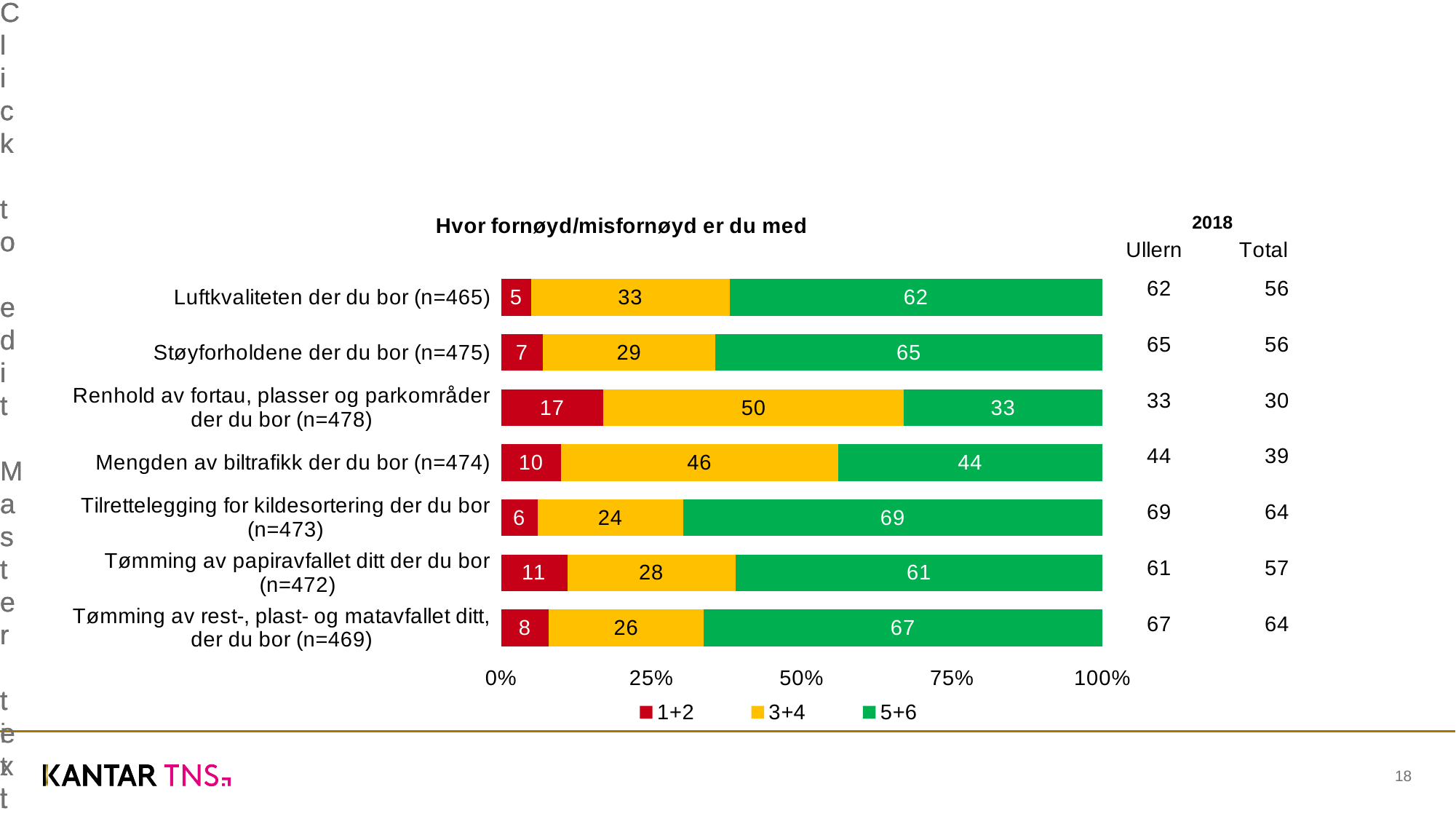
How many series does the legend list? 3 How many categories are shown in the chart? 7 What is the value of the 3+4 segment for Mengden av biltrafikk der du bor (n=474)? 46 What is the title of the chart? Hvor fornøyd/misfornøyd er du med Which category has the highest 5+6 value? Tilrettelegging for kildesortering der du bor (n=473) What kind of chart is shown on the slide? Stacked bar chart What is the value of the 5+6 segment for Luftkvaliteten der du bor (n=465)? 62 Which category has the lowest 5+6 value? Renhold av fortau, plasser og parkområder der du bor (n=478) What is the difference between the 5+6 values for Støyforholdene der du bor (n=475) and Luftkvaliteten der du bor (n=465)? 3 What is the value of the 1+2 segment for Renhold av fortau, plasser og parkområder der du bor (n=478)? 17 Which is larger: the 3+4 value for Tømming av papiravfallet ditt der du bor (n=472) or the 3+4 value for Tømming av rest-, plast- og matavfallet ditt, der du bor (n=469)? Tømming av papiravfallet ditt der du bor (n=472) Which category has the highest 1+2 value? Renhold av fortau, plasser og parkområder der du bor (n=478)